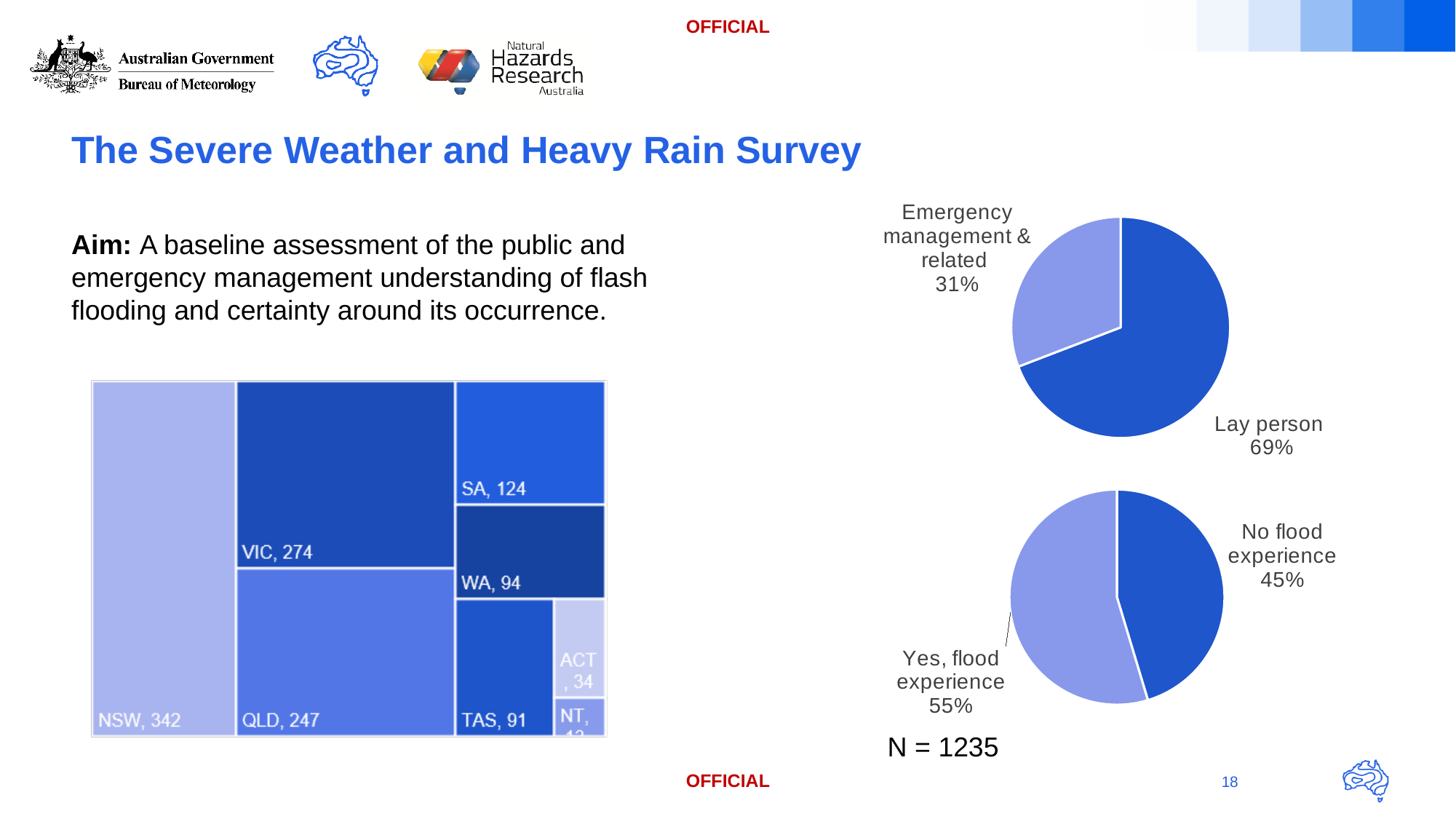
In the treemap on the left, what is the value for VIC? 274 What kind of chart is the chart on the left of the slide? Treemap In the bottom pie chart on the right, what share is labelled No flood experience? 45% In the top pie chart on the right, what share is labelled Emergency management & related? 31% In the treemap on the left, what is the difference between the values for VIC and QLD? 27 In the treemap on the left, which is larger, the value for SA or the value for TAS? SA In the treemap on the left, which state or territory has the highest value? NSW In the bottom pie chart on the right, which slice is larger, Yes, flood experience or No flood experience? Yes, flood experience In the treemap on the left, what is the value for NSW? 342 In the top pie chart on the right, what share is labelled Lay person? 69% In the treemap on the left, what is the value for WA? 94 In the treemap on the left, what is the difference between the values for NSW and ACT? 308